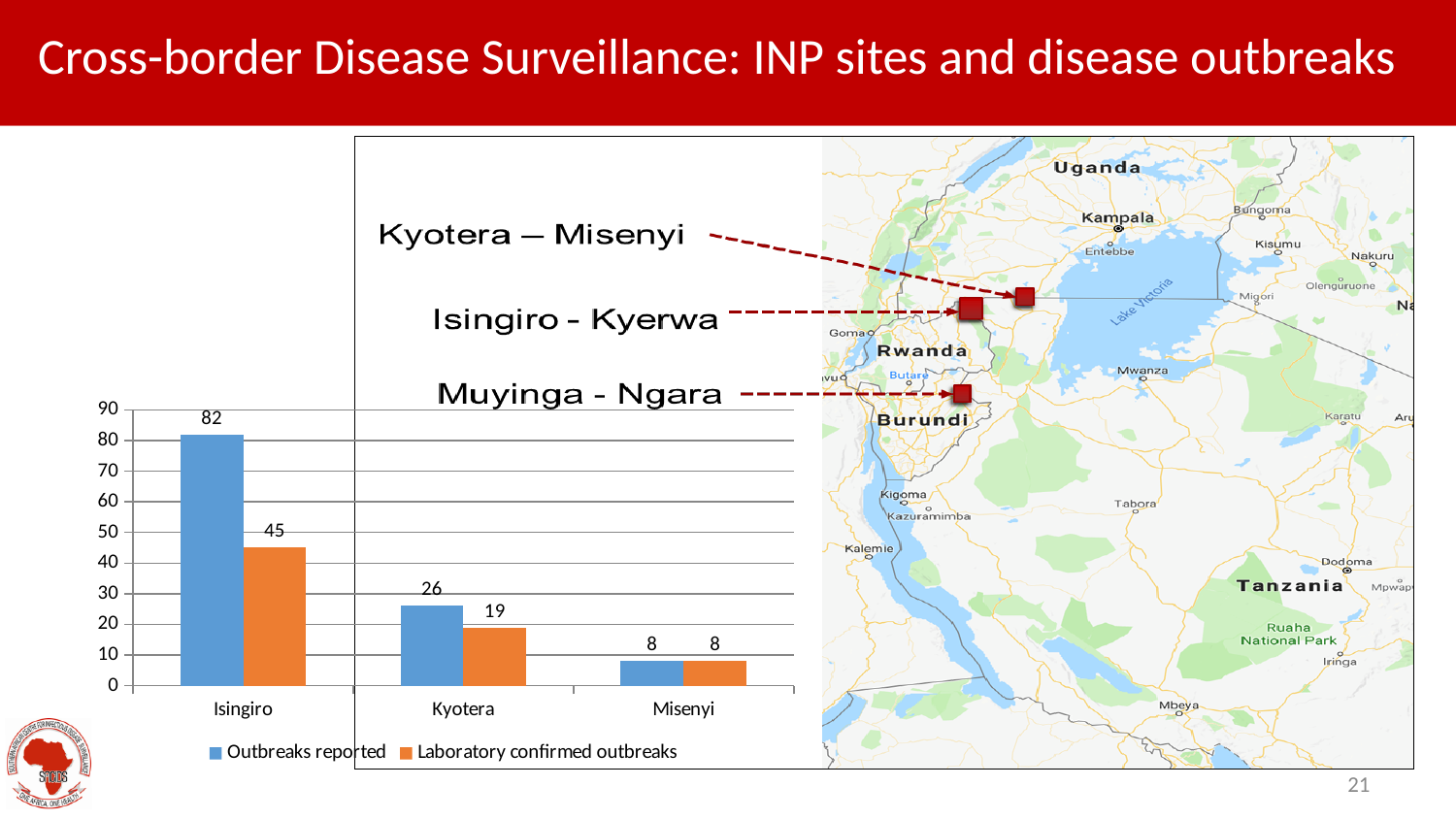
What is the difference between Outbreaks reported and Laboratory confirmed outbreaks in Isingiro? 37 What is the value for Outbreaks reported in Isingiro? 82 Which colour represents Laboratory confirmed outbreaks in the chart? Orange What is the value for Outbreaks reported in Misenyi? 8 Which is larger: Laboratory confirmed outbreaks in Isingiro or Outbreaks reported in Kyotera? Laboratory confirmed outbreaks in Isingiro What is the value for Laboratory confirmed outbreaks in Kyotera? 19 How many categories are shown on the x axis of the chart? 3 Which category has the lowest value for Laboratory confirmed outbreaks? Misenyi What kind of chart is shown on the slide? Bar chart Which category has the highest value for Outbreaks reported? Isingiro How many series does the chart legend list? 2 What is the difference between Outbreaks reported in Kyotera and Outbreaks reported in Misenyi? 18